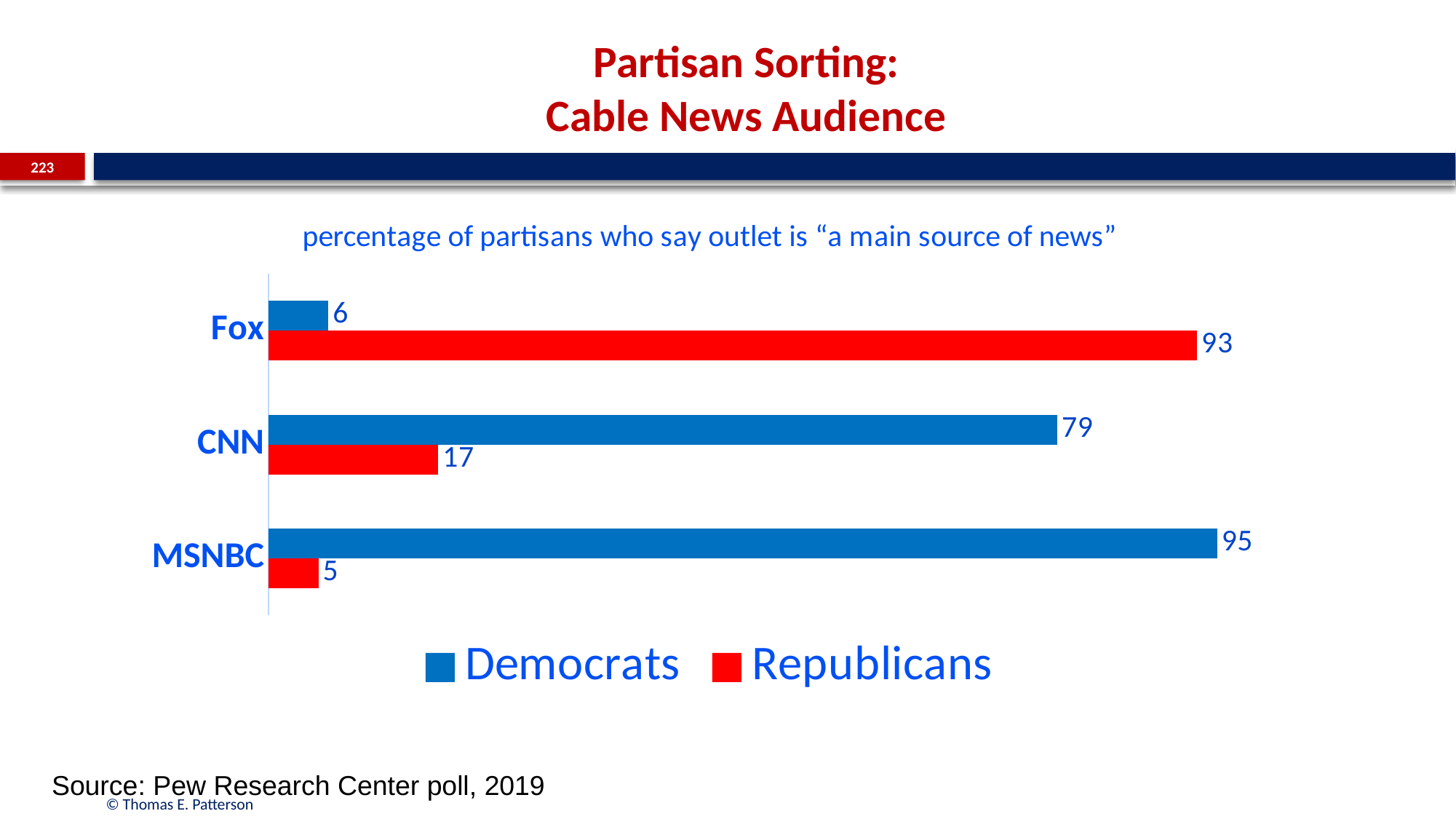
What is the value for Democrats for MSNBC? 95 How many outlets are shown on the chart? 3 Which is larger for Fox: the Democrats value or the Republicans value? Republicans Which outlet has the highest value among Democrats? MSNBC What percentage of Republicans say Fox is a main source of news? 93 What is the difference between the Democrats and Republicans values for CNN? 62 Which outlet has the lowest value among Republicans? MSNBC How many series does the legend list? 2 What percentage of Democrats say Fox is a main source of news? 6 What is the value for Republicans for CNN? 17 Which colour represents Republicans in the chart? Red What kind of chart is shown on the slide? Bar chart